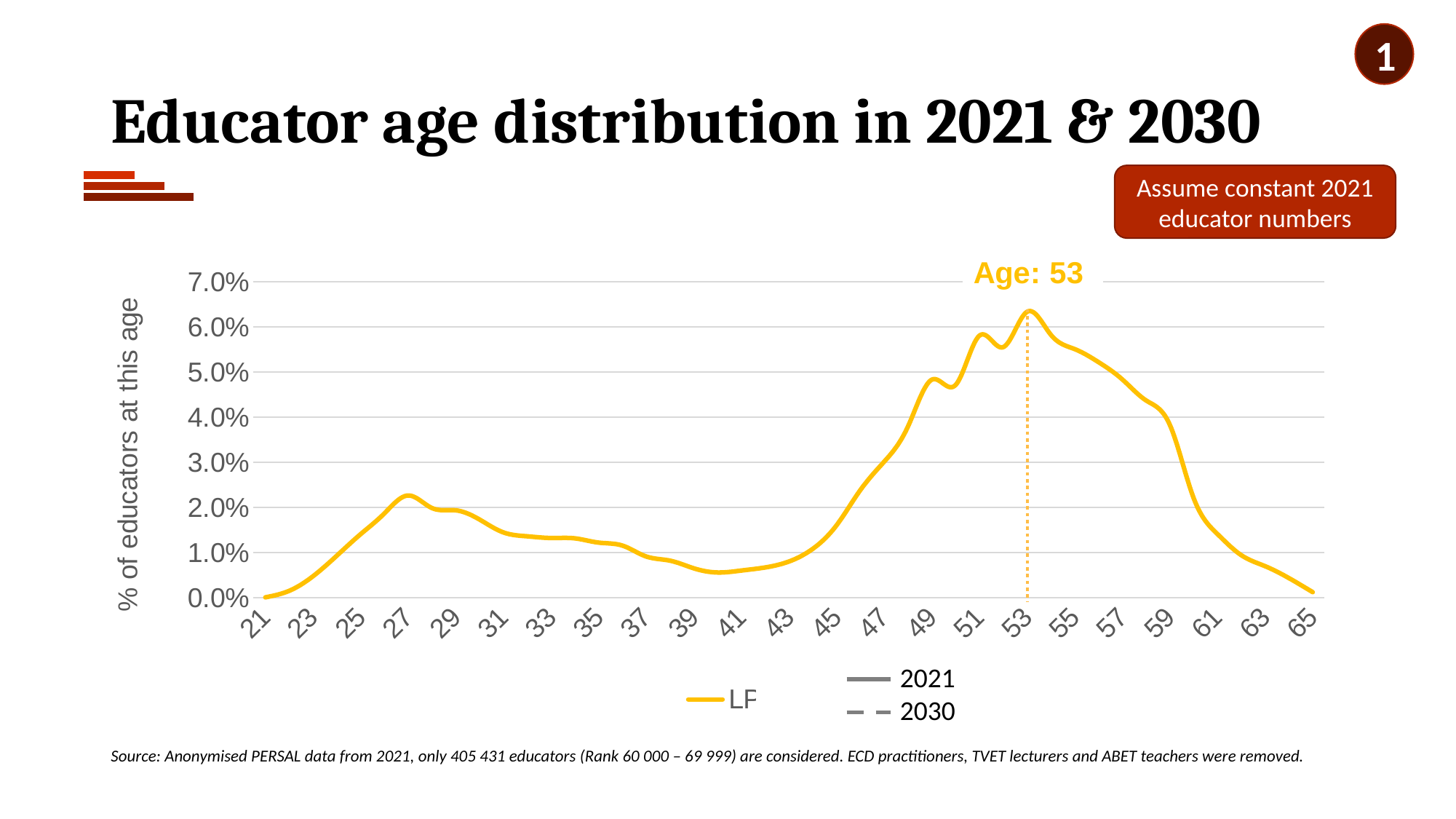
Do the values rise or fall along the x axis from age 53 to age 65? fall Which has the larger value, age 41 or age 27? age 27 Is the value for age 27 greater or less than 2.0%? greater Do the values rise or fall along the x axis from age 43 to age 53? rise What is the label on the vertical axis of the chart? % of educators at this age Which has the larger value, age 27 or age 53? age 53 At which age does the LF line reach its highest value? 53 Is the value for age 41 greater or less than 1.0%? less What kind of chart is shown on the slide? line chart Is the value for age 65 greater or less than 1.0%? less